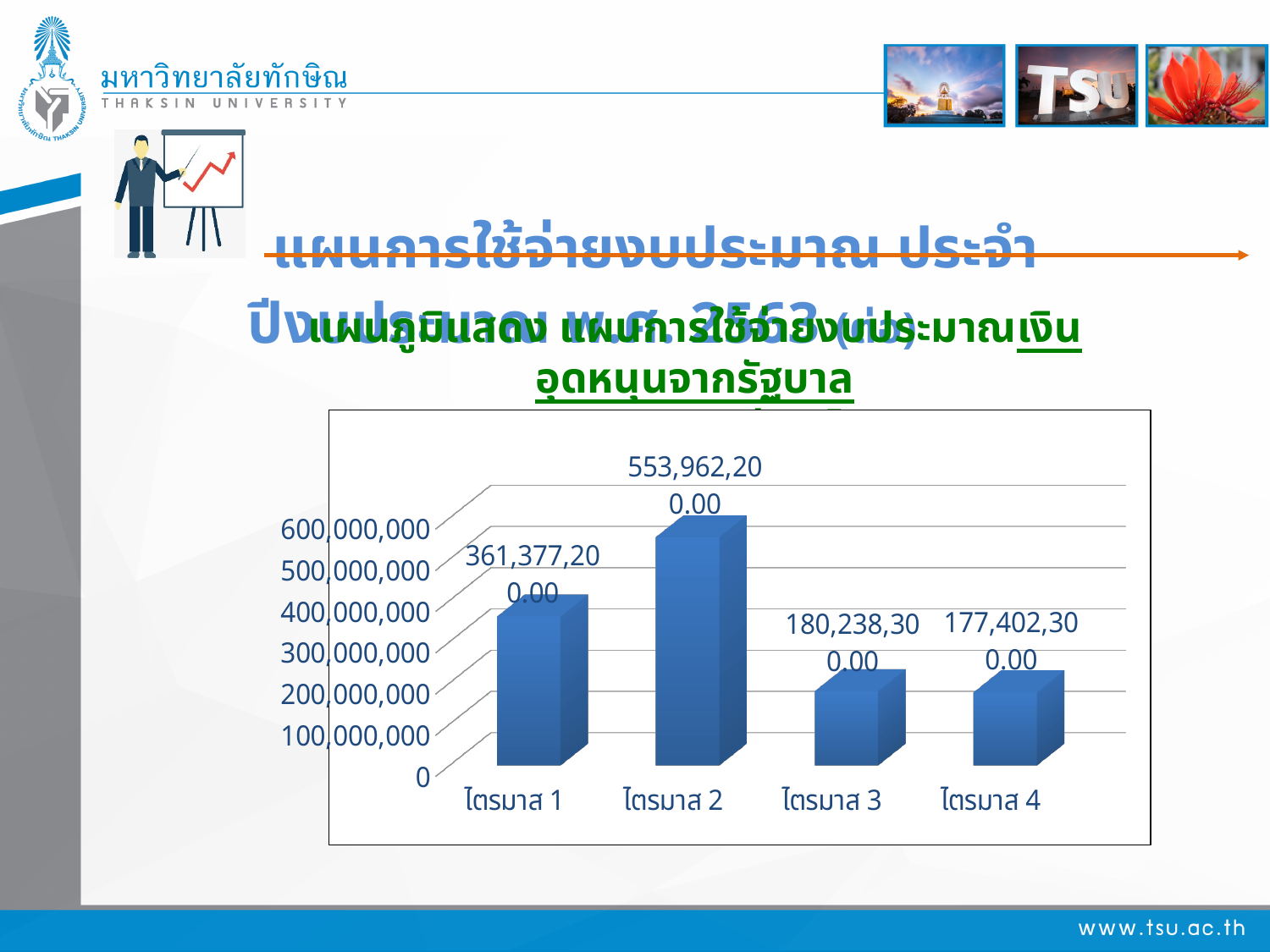
What is the value for ไตรมาส 1? 361,377,200.00 What is the value for ไตรมาส 3? 180,238,300.00 What is the difference between the values for ไตรมาส 2 and ไตรมาส 1? 192,585,000.00 Which quarter has the highest value? ไตรมาส 2 What is the value for ไตรมาส 4? 177,402,300.00 Which quarter has the lowest value? ไตรมาส 4 What is the value for ไตรมาส 2? 553,962,200.00 Is the value for ไตรมาส 1 greater or less than 300,000,000? greater What is the total of the four quarterly values? 1,272,980,000.00 Which is larger, the value for ไตรมาส 3 or ไตรมาส 4? ไตรมาส 3 How many quarters are shown on the x axis? 4 What kind of chart is shown on the slide? bar chart